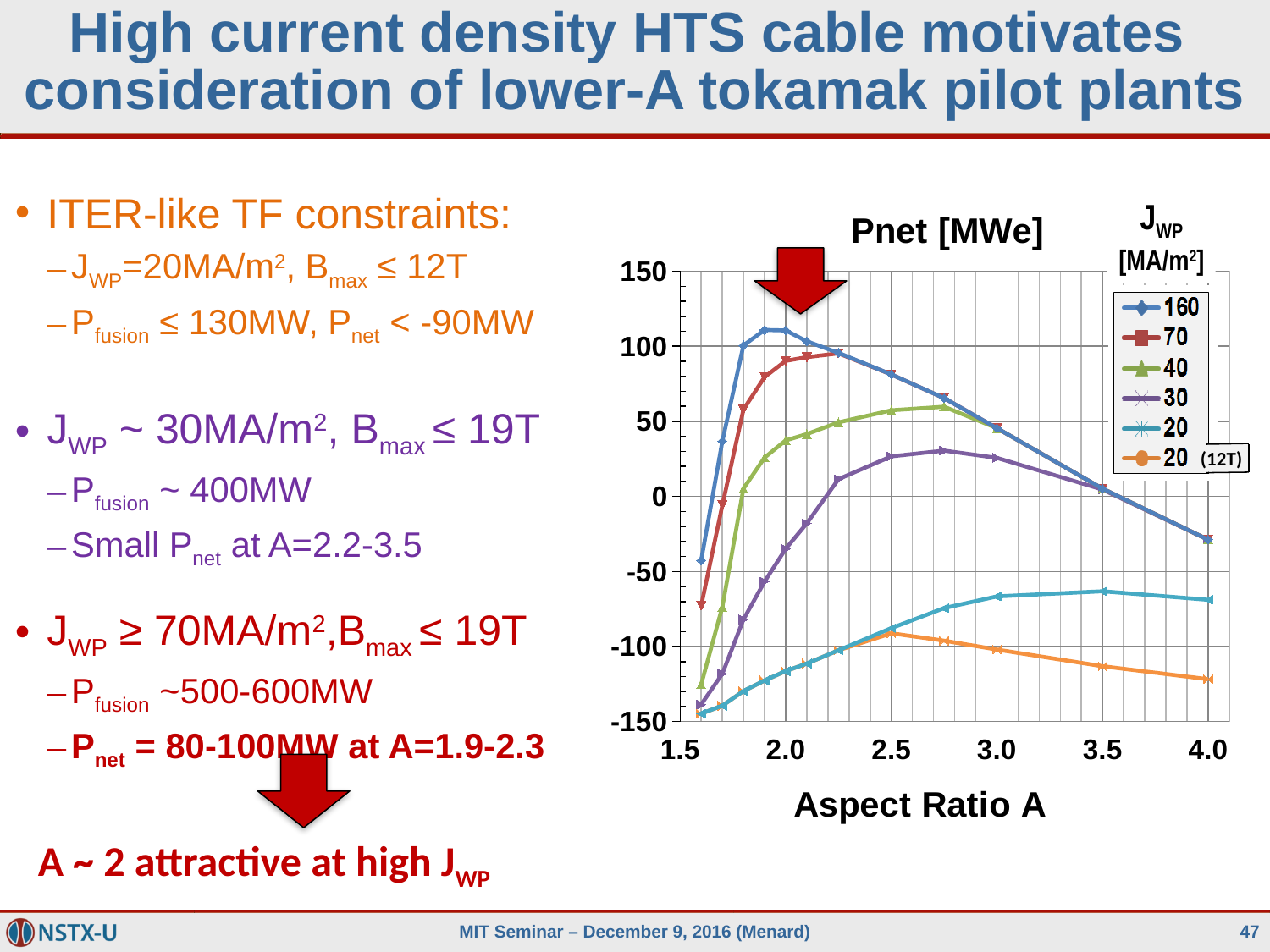
What is the title of the chart? Pnet [MWe] What is the label of the x axis of the chart? Aspect Ratio A Do the values of the 160 series rise or fall as Aspect Ratio A increases from 2.0 to 4.0? fall How many series does the legend of the chart list? 6 Is the value of the 40 series at Aspect Ratio A = 3.0 greater or less than 0? greater Which series has the lowest value at Aspect Ratio A = 4.0? 20 (12T) Is the value of the 160 series at Aspect Ratio A = 4.0 greater or less than 0? less Is the value of the 20 (12T) series at Aspect Ratio A = 4.0 greater or less than -100? less What kind of chart is shown on the slide? line chart At Aspect Ratio A = 2.0, which series has the higher value, 160 or 30? 160 At Aspect Ratio A = 3.5, which series has the higher value, 20 or 20 (12T)? 20